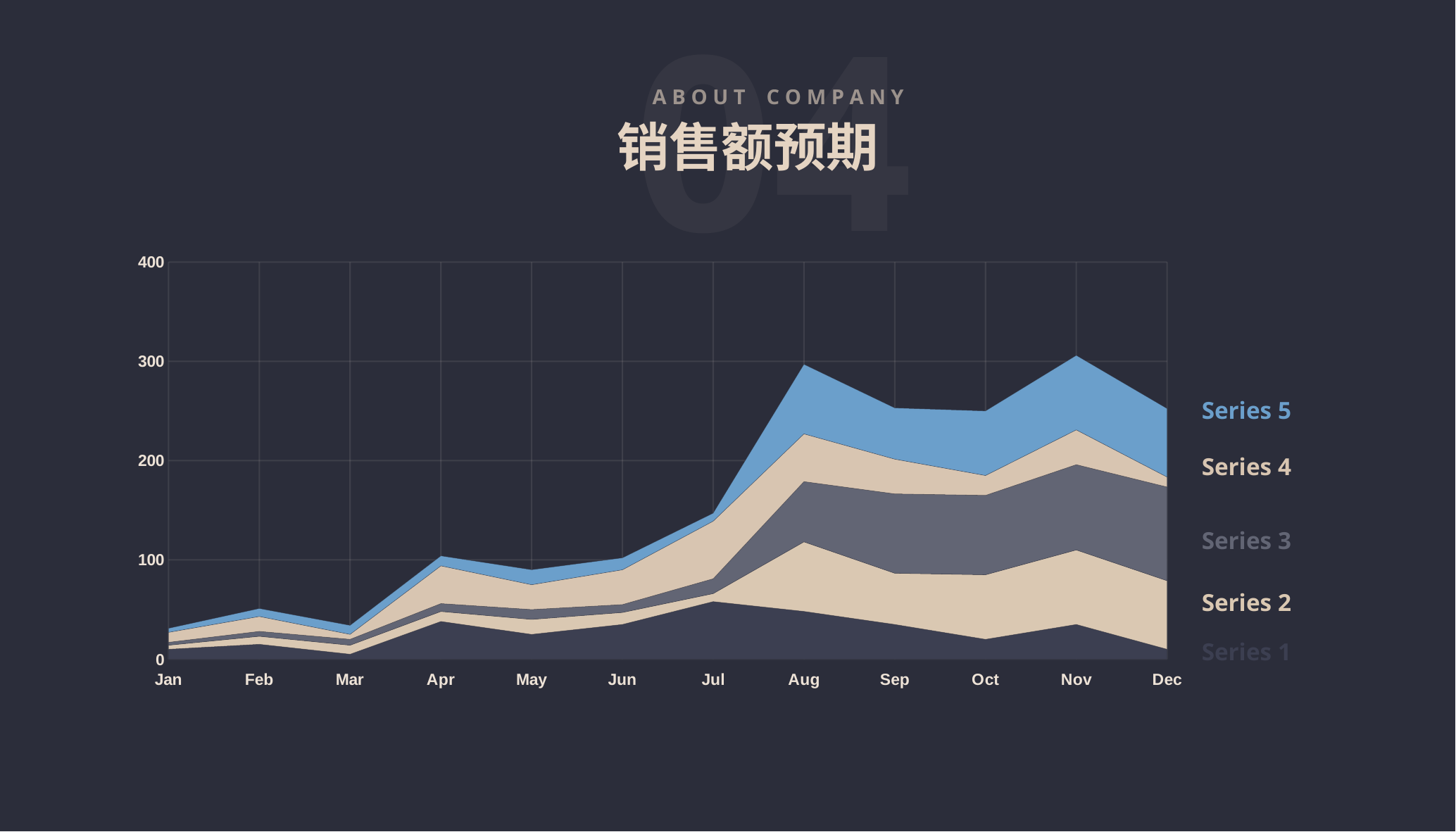
Which series is shown in blue at the top of the stack? Series 5 Is the total stacked value for Mar greater or less than 100? less What is the title of the chart slide? 销售额预期 What kind of chart is shown on the slide? stacked area chart Is the total stacked value for Jul greater or less than 200? less Does the total stacked value generally rise or fall from Jan to Aug? rise Which month has the larger total stacked value, Aug or Jul? Aug Is the total stacked value for Sep greater or less than 200? greater How many series does the legend list? 5 How many months are plotted along the x axis? 12